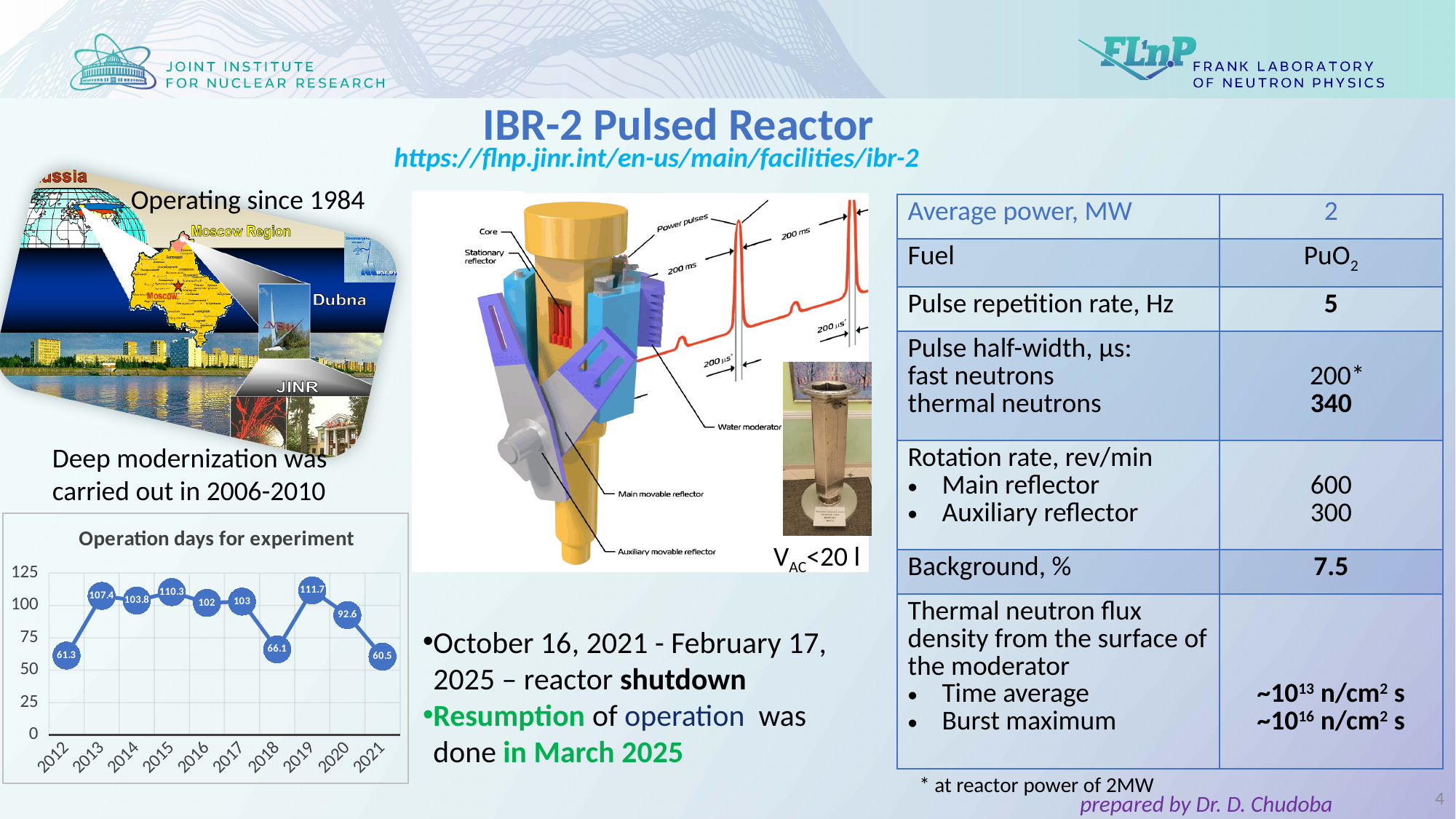
What type of chart is used to show operation days for experiment? line chart Which year has the lowest number of operation days for experiment? 2021 What is the value for 2012 in the operation days chart? 61.3 Which year has more operation days for experiment, 2013 or 2014? 2013 Is the value for 2018 in the operation days chart greater or less than 75? less What is the difference in operation days between 2019 and 2018? 45.6 What is the value for 2020 in the operation days chart? 92.6 What is the value for 2019 in the operation days chart? 111.7 What is the title of the chart on the slide? Operation days for experiment Which year has the highest number of operation days for experiment? 2019 How many years are plotted in the operation days chart? 10 In the operation days chart, do the values rise or fall from 2019 to 2021? fall